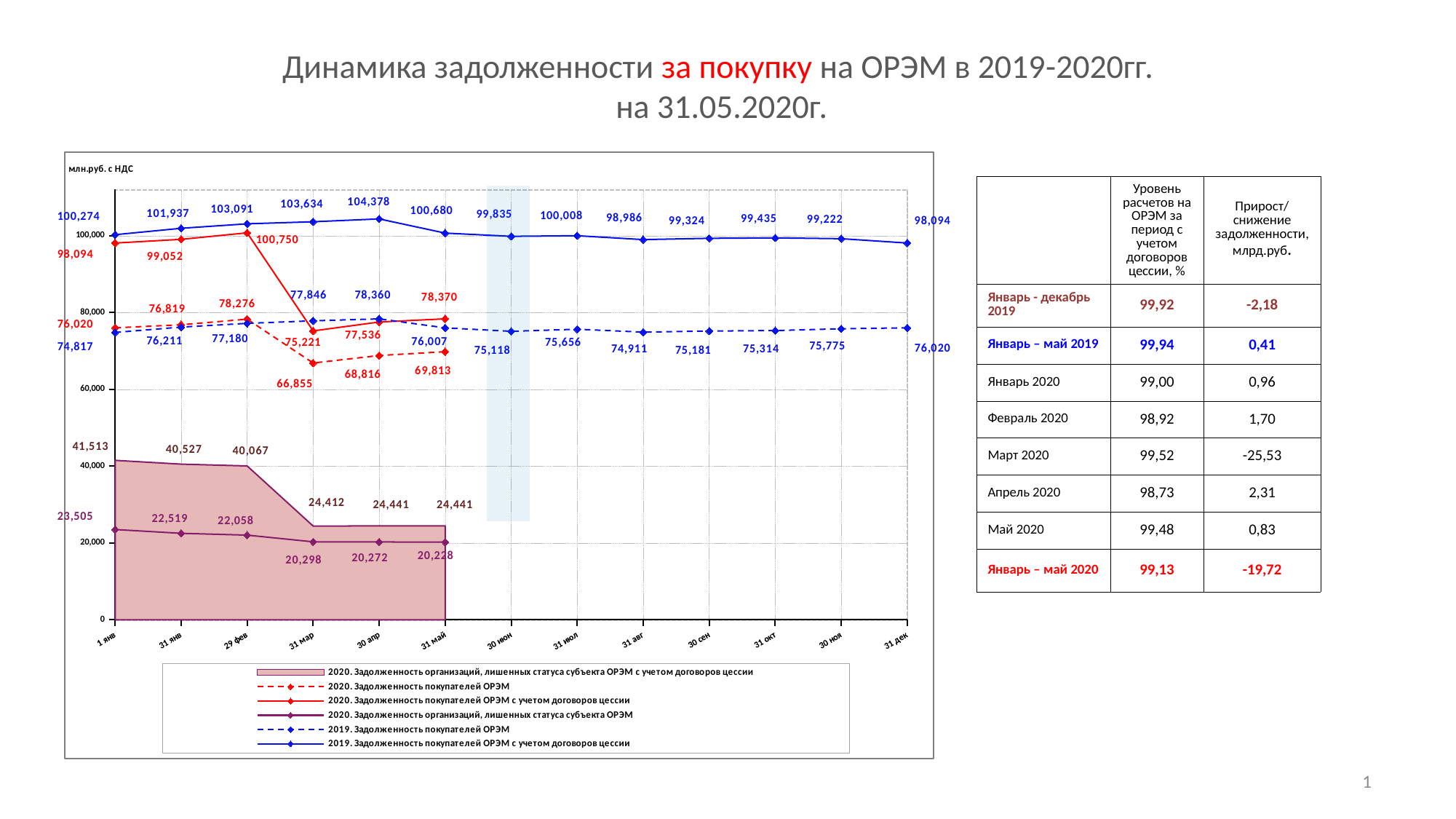
What unit is stated in the top-left corner of the chart? млн.руб. с НДС What kind of chart is shown on the slide? Line chart with a shaded area series How many series does the chart legend list? 6 What value does the 2020 series "Задолженность организаций, лишенных статуса субъекта ОРЭМ" show at 1 янв? 23,505 How many dates are labelled on the x axis of the chart? 13 What value does the 2019 series "Задолженность покупателей ОРЭМ с учетом договоров цессии" show at 30 апр? 104,378 What value does the 2020 series "Задолженность покупателей ОРЭМ с учетом договоров цессии" show at 31 мар? 75,221 Which is larger at 31 май: the 2019 "Задолженность покупателей ОРЭМ" value or the 2020 "Задолженность покупателей ОРЭМ" value? 2019 (76,007) Is the 2020 "Задолженность организаций, лишенных статуса субъекта ОРЭМ с учетом договоров цессии" value at 31 май greater or less than 40,000? less What is the difference between the 2020 "Задолженность покупателей ОРЭМ с учетом договоров цессии" values at 29 фев and 31 мар? 25,529 At which date does the 2020 series "Задолженность покупателей ОРЭМ" (dashed red line) reach its lowest value? 31 мар At which date does the 2019 series "Задолженность покупателей ОРЭМ с учетом договоров цессии" reach its highest value? 30 апр